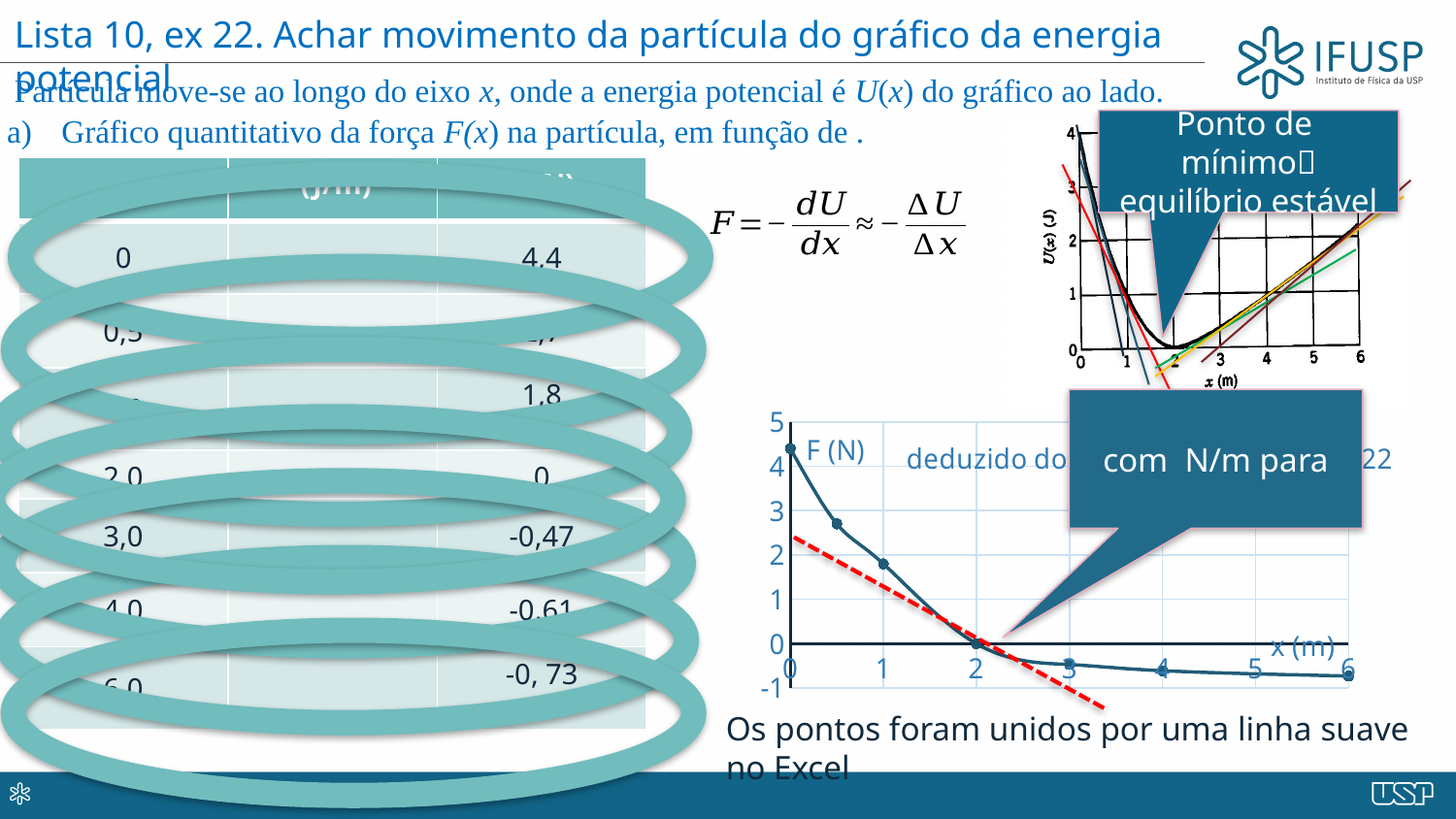
What kind of chart is the F (N) versus x (m) chart on the slide? line chart In the F (N) versus x (m) chart, at which x value is F highest? 0 What colour is the dashed straight line drawn over the F (N) versus x (m) chart? red In the F (N) versus x (m) chart, is the value of F at x = 1 greater or less than 2? less In the F (N) versus x (m) chart, do the values rise or fall as x increases? fall In the F (N) versus x (m) chart, which is larger: F at x = 1 or F at x = 3? F at x = 1 In the F (N) versus x (m) chart, is the value of F at x = 6 greater or less than -1? greater How many data points are plotted in the F (N) versus x (m) chart? 7 In the F (N) versus x (m) chart, is the value of F at x = 0 greater or less than 4? greater In the F (N) versus x (m) chart, what is the value of F at x = 2? 0 What is the label of the vertical axis in the F versus x chart? F (N)